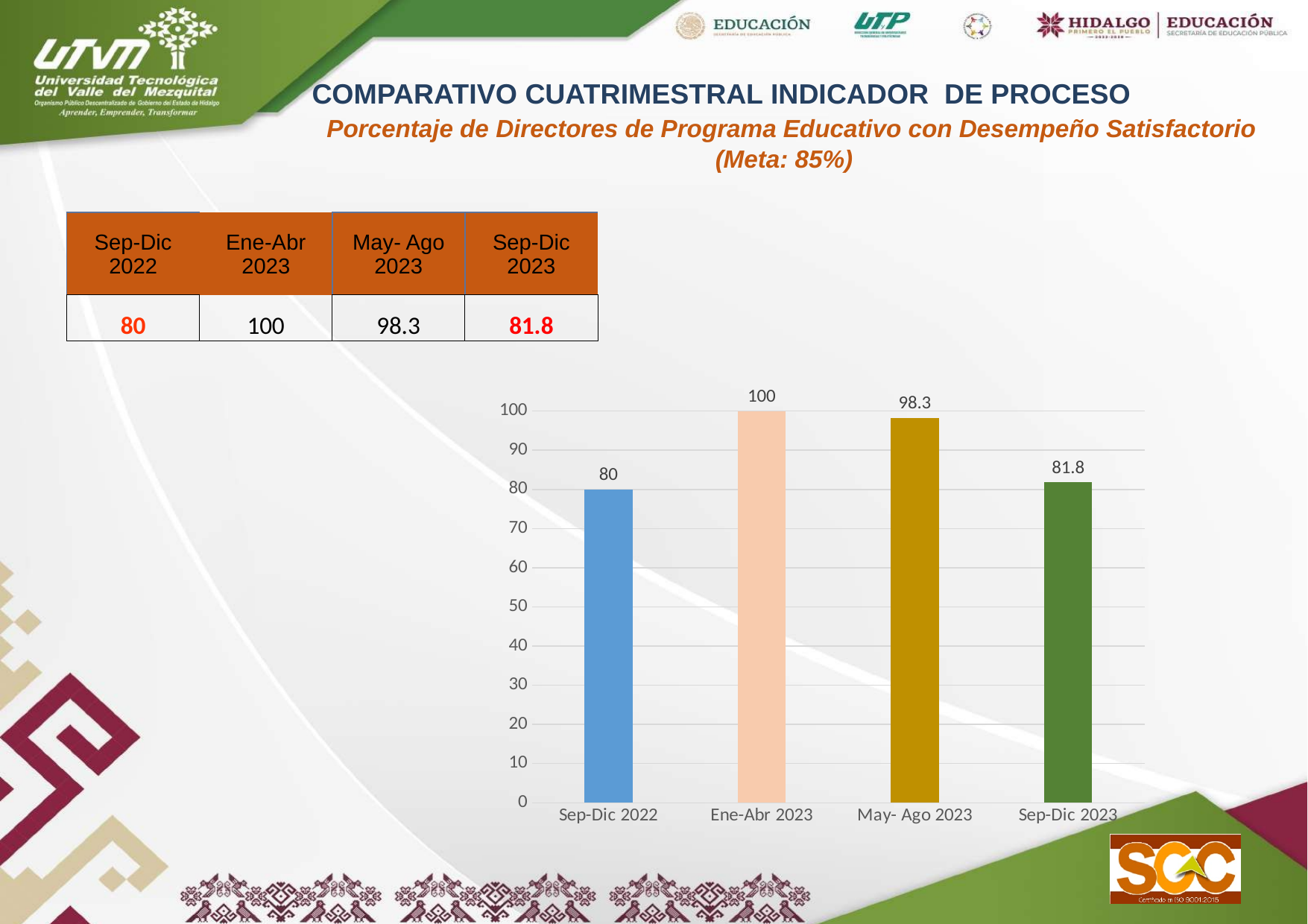
Is the value for May- Ago 2023 greater or less than 90? greater What is the value for Ene-Abr 2023? 100 Which period has the highest value? Ene-Abr 2023 Which is larger, the value for Sep-Dic 2022 or the value for Sep-Dic 2023? Sep-Dic 2023 What is the difference between the values for Ene-Abr 2023 and Sep-Dic 2023? 18.2 How many periods are shown on the chart? 4 What is the difference between the values for May- Ago 2023 and Sep-Dic 2022? 18.3 What kind of chart is shown on the slide? Bar chart Which period has the lowest value? Sep-Dic 2022 What is the value for Sep-Dic 2023? 81.8 What is the value for Sep-Dic 2022? 80 What is the value for May- Ago 2023? 98.3